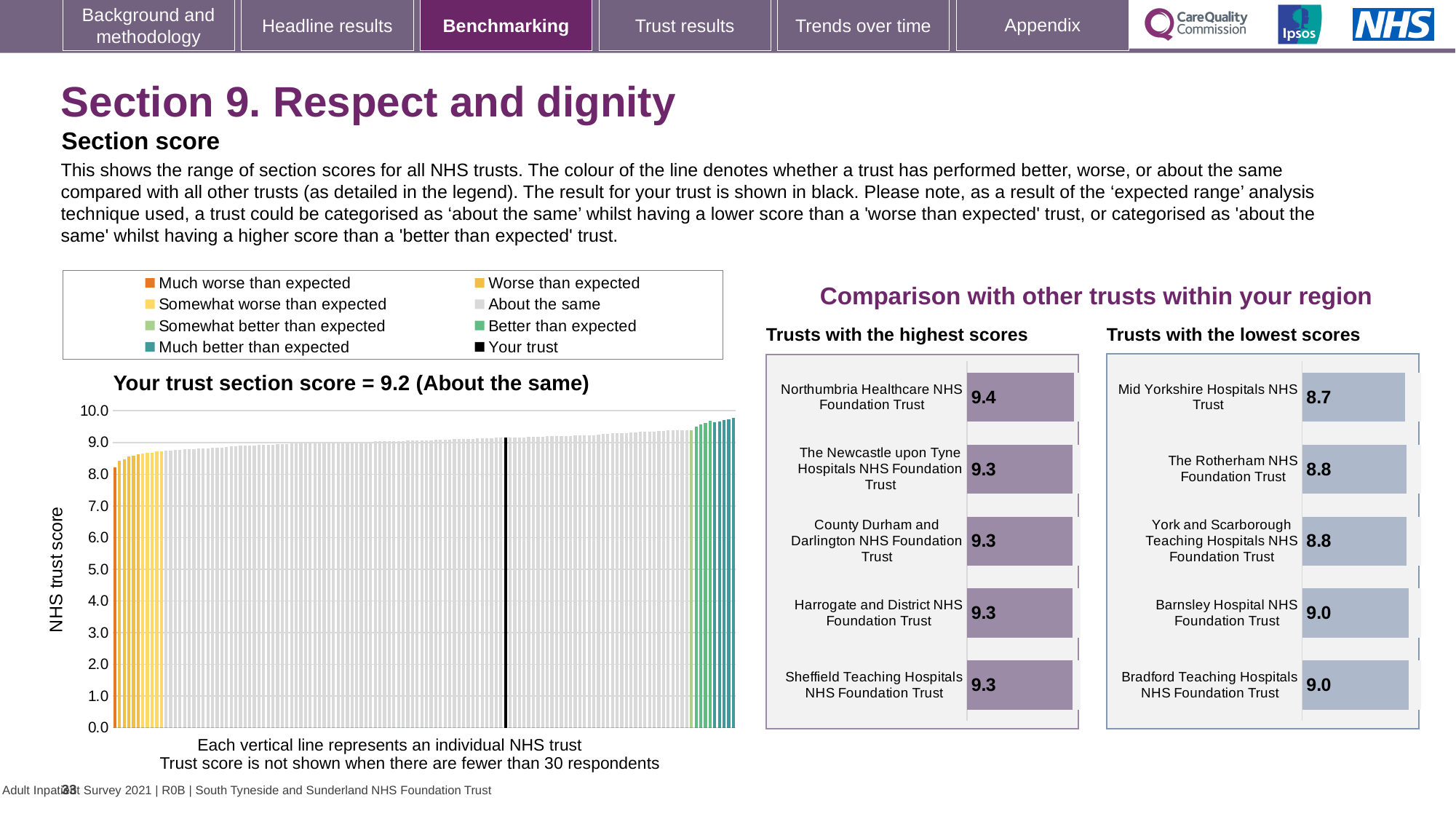
In the 'Trusts with the lowest scores' chart, what is the score for Barnsley Hospital NHS Foundation Trust? 9.0 In the 'Trusts with the highest scores' chart, how many trusts are shown? 5 In the 'Trusts with the lowest scores' chart, what is the score for Mid Yorkshire Hospitals NHS Trust? 8.7 In the 'Trusts with the highest scores' chart, which trust has the highest score? Northumbria Healthcare NHS Foundation Trust In the 'Trusts with the lowest scores' chart, which has the larger score: Barnsley Hospital NHS Foundation Trust or The Rotherham NHS Foundation Trust? Barnsley Hospital NHS Foundation Trust In the 'Trusts with the highest scores' chart, what is the difference between the scores of Northumbria Healthcare NHS Foundation Trust and Sheffield Teaching Hospitals NHS Foundation Trust? 0.1 What kind of chart is the 'Your trust section score' chart on the left? Bar chart In the 'Your trust section score' chart on the left, what is the section score for your trust? 9.2 In the 'Trusts with the highest scores' chart, what is the score for Northumbria Healthcare NHS Foundation Trust? 9.4 In the 'Trusts with the lowest scores' chart, what is the difference between the scores of Bradford Teaching Hospitals NHS Foundation Trust and Mid Yorkshire Hospitals NHS Trust? 0.3 In the 'Trusts with the lowest scores' chart, which trust has the lowest score? Mid Yorkshire Hospitals NHS Trust In the 'Your trust section score' chart on the left, do the trust scores rise or fall from left to right along the x axis? Rise